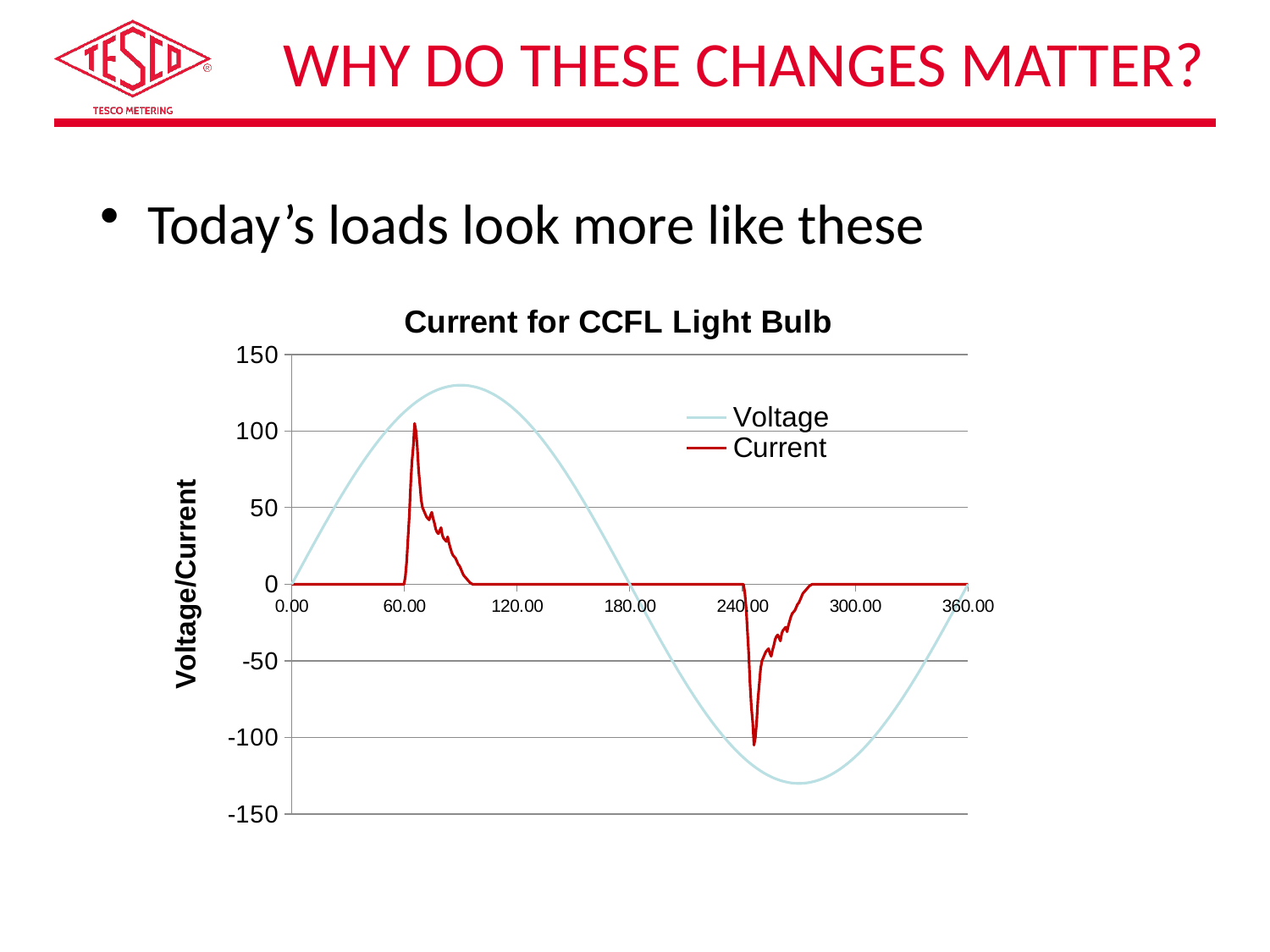
Is the peak value of the Current series greater or less than 50? greater What are the two series named in the legend? Voltage and Current Is the peak value of the Voltage series greater or less than 100? greater Is the lowest value of the Current series greater or less than -50? less How many series does the legend list? 2 Does the Voltage series rise or fall between 0.00 and 60.00 on the x axis? rise What kind of chart is shown on the slide? line chart How many tick labels are shown on the x axis? 7 Does the Voltage series rise or fall between 180.00 and 240.00 on the x axis? fall Which series reaches a higher peak value, Voltage or Current? Voltage What is the title of the chart? Current for CCFL Light Bulb